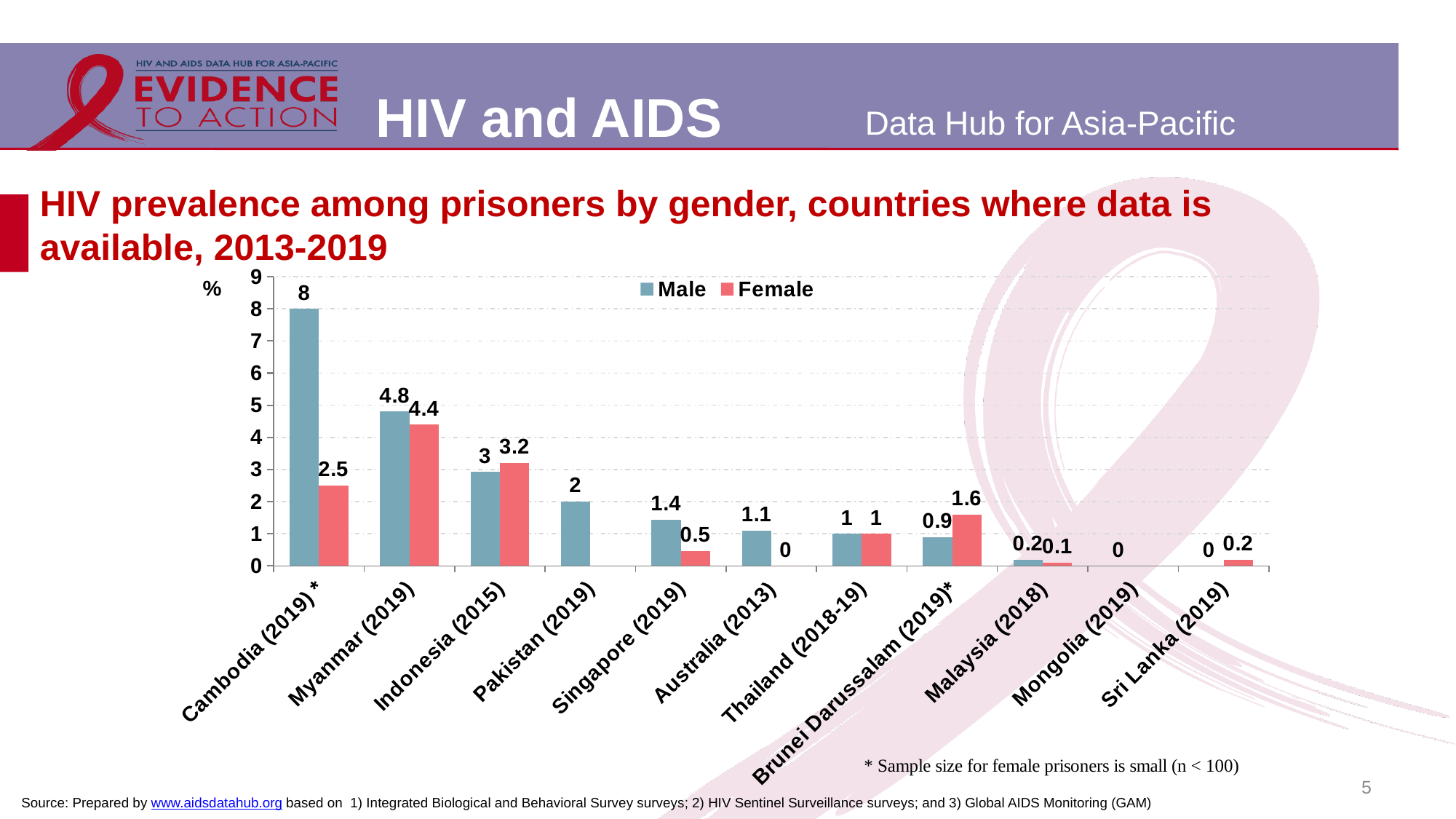
What is the value for female prisoners in Brunei Darussalam (2019)? 1.6 In Singapore (2019), is the male or female value larger? Male How many series does the legend list? 2 What type of chart is shown on the slide? Bar chart How many countries are shown on the x axis? 11 What is the difference between the male and female values for Cambodia (2019)? 5.5 In Brunei Darussalam (2019), is the male or female value larger? Female Which country has the highest HIV prevalence among female prisoners? Myanmar (2019) Which country has the highest HIV prevalence among male prisoners? Cambodia (2019) What is the HIV prevalence among female prisoners in Myanmar (2019)? 4.4 What is the difference between the female and male values for Indonesia (2015)? 0.2 What is the HIV prevalence among male prisoners in Cambodia (2019)? 8